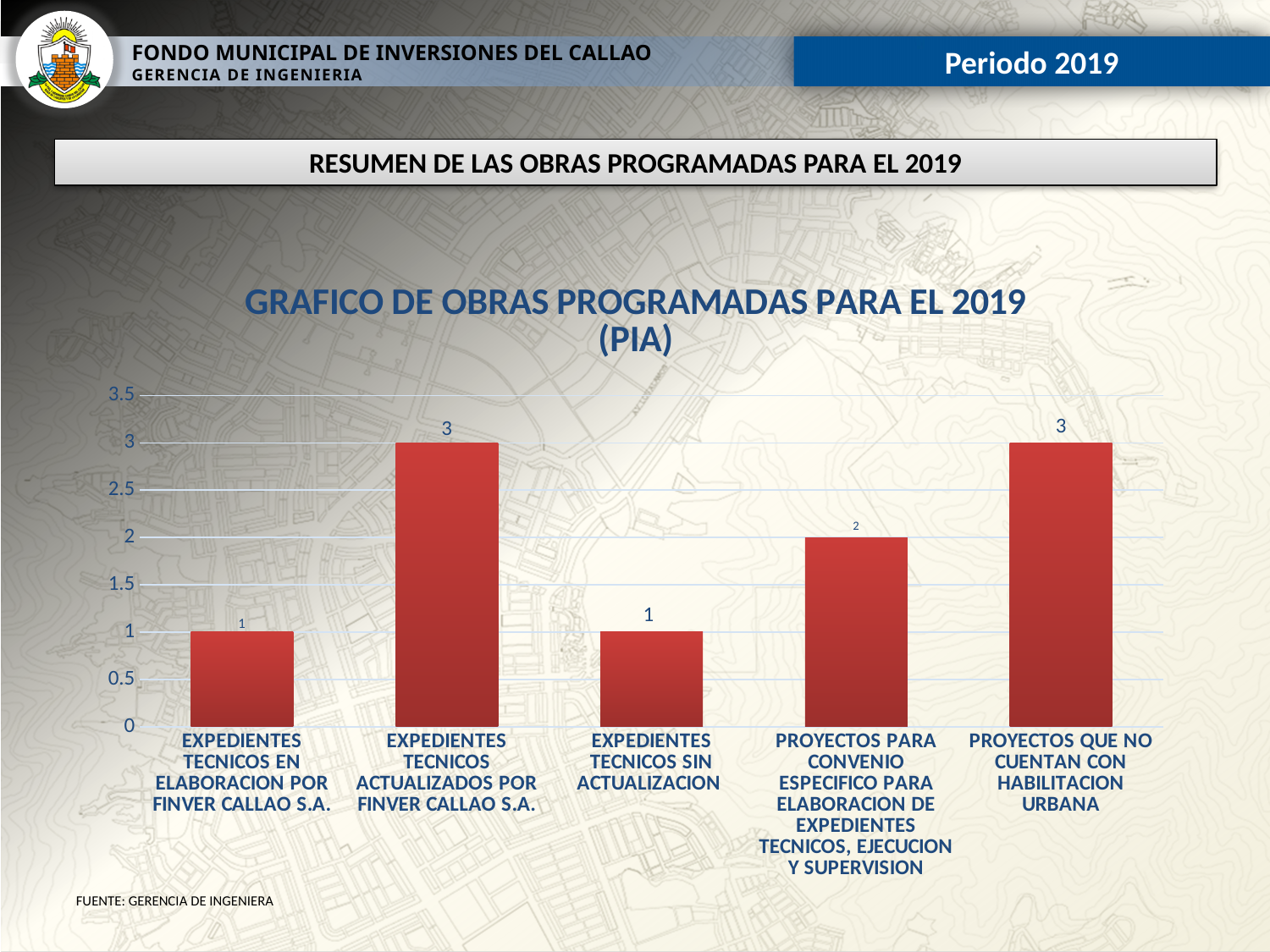
What is the value for EXPEDIENTES TECNICOS SIN ACTUALIZACION? 1 What kind of chart is shown on the slide? bar chart What is the value for EXPEDIENTES TECNICOS EN ELABORACION POR FINVER CALLAO S.A.? 1 What is the value for PROYECTOS PARA CONVENIO ESPECIFICO PARA ELABORACION DE EXPEDIENTES TECNICOS, EJECUCION Y SUPERVISION? 2 What is the difference between the value for PROYECTOS QUE NO CUENTAN CON HABILITACION URBANA and the value for EXPEDIENTES TECNICOS SIN ACTUALIZACION? 2 What is the title of the chart? GRAFICO DE OBRAS PROGRAMADAS PARA EL 2019 (PIA) What is the value for EXPEDIENTES TECNICOS ACTUALIZADOS POR FINVER CALLAO S.A.? 3 Which is larger, the value for PROYECTOS PARA CONVENIO ESPECIFICO PARA ELABORACION DE EXPEDIENTES TECNICOS, EJECUCION Y SUPERVISION or the value for EXPEDIENTES TECNICOS SIN ACTUALIZACION? PROYECTOS PARA CONVENIO ESPECIFICO PARA ELABORACION DE EXPEDIENTES TECNICOS, EJECUCION Y SUPERVISION What is the value for PROYECTOS QUE NO CUENTAN CON HABILITACION URBANA? 3 Is the value for EXPEDIENTES TECNICOS ACTUALIZADOS POR FINVER CALLAO S.A. greater or less than 2? greater What is the highest value shown on the vertical axis? 3.5 How many categories are shown in the chart? 5